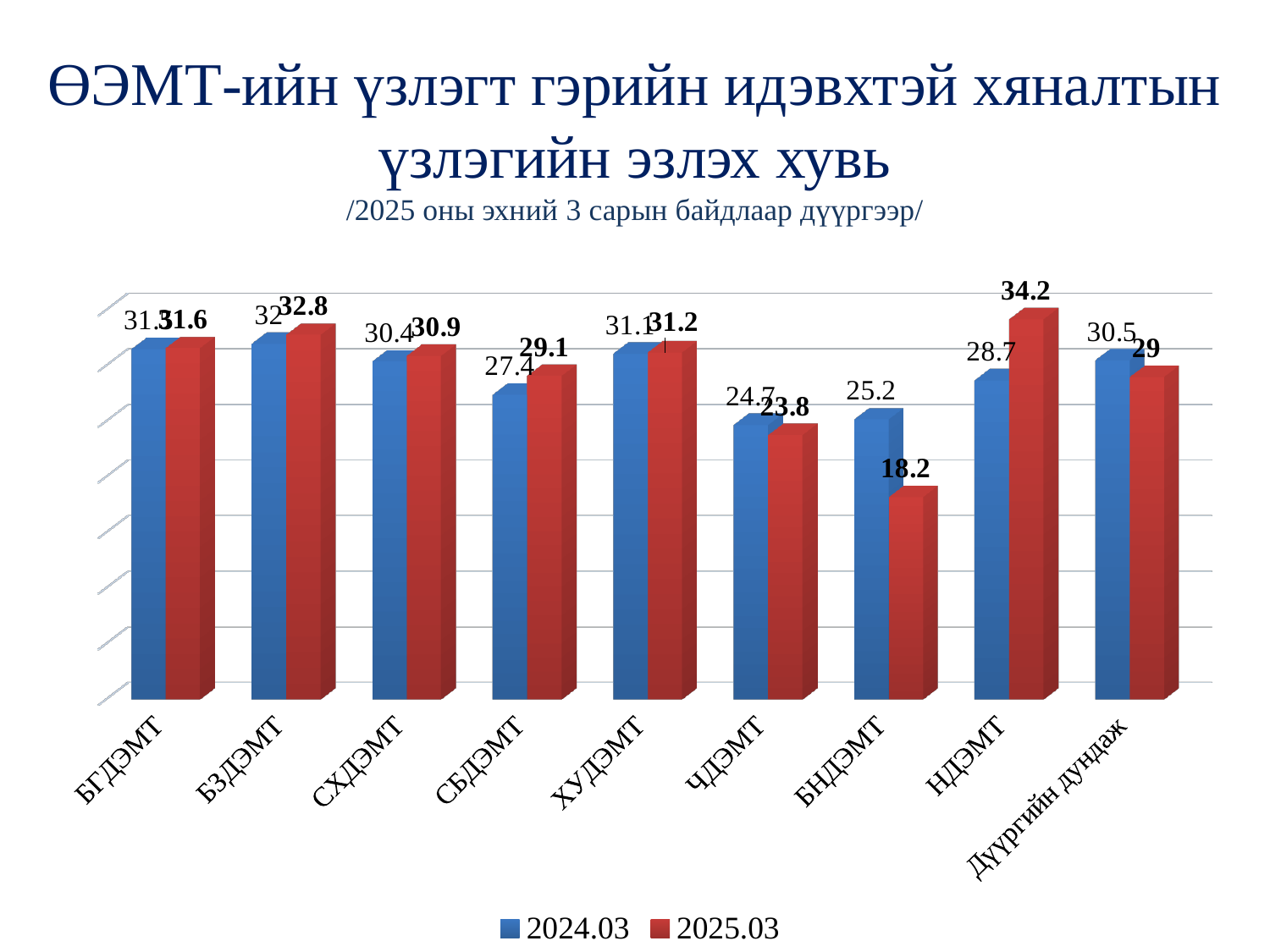
Which category has the highest 2025.03 value? НДЭМТ What is the 2025.03 value for НДЭМТ? 34.2 By how much did the value for НДЭМТ increase from 2024.03 to 2025.03? 5.5 Which category has the highest 2024.03 value? БЗДЭМТ What is the difference between the 2024.03 and 2025.03 values for БНДЭМТ? 7 How many series does the legend list? 2 How many categories are shown on the x axis? 9 For ЧДЭМТ, which series has the larger value, 2024.03 or 2025.03? 2024.03 What kind of chart is shown on the slide? Bar chart What is the 2025.03 value for Дүүргийн дундаж? 29 What is the 2024.03 value for БНДЭМТ? 25.2 Which category has the lowest 2025.03 value? БНДЭМТ